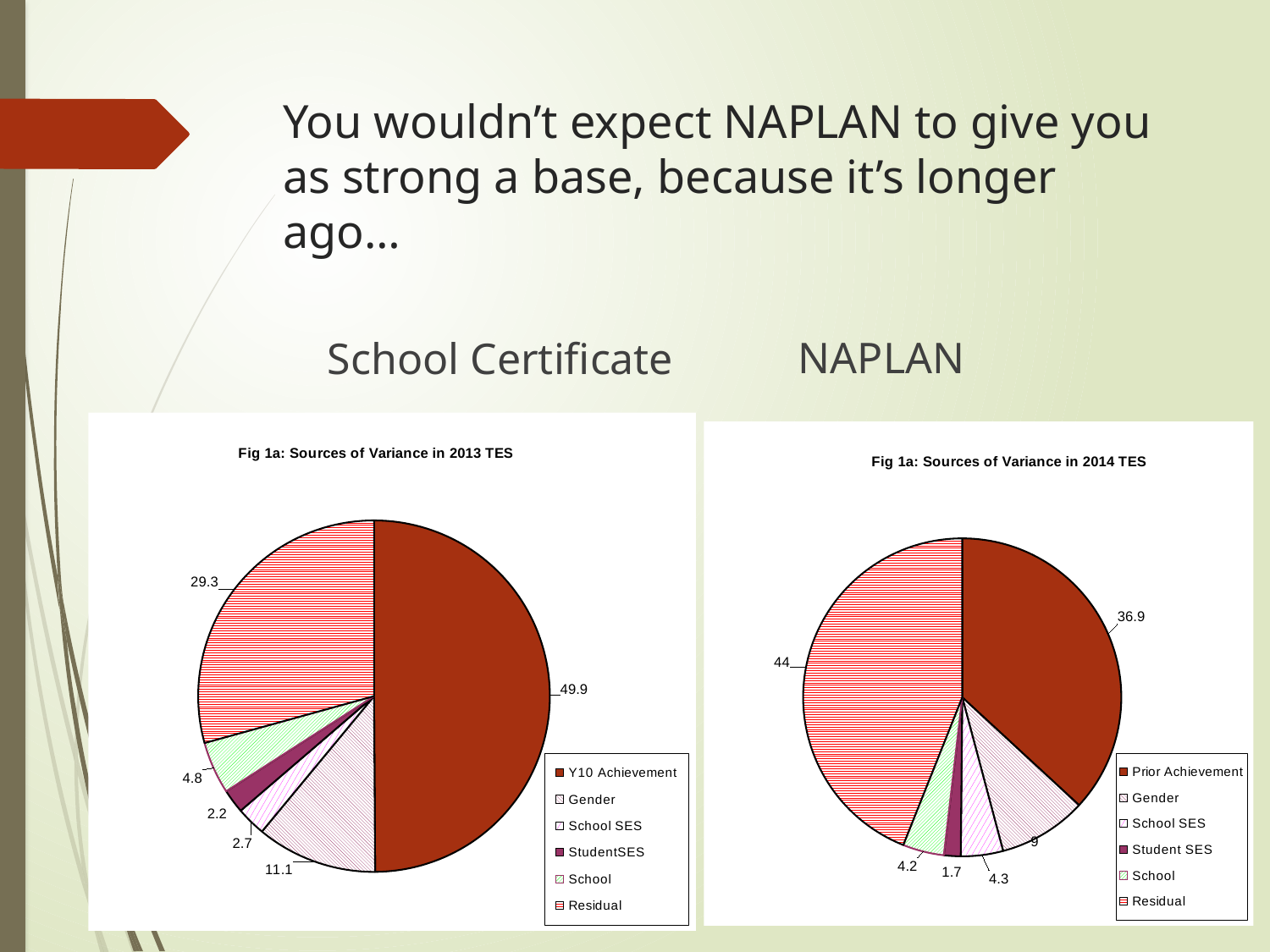
In the School Certificate chart (2013 TES), which source of variance has the smallest slice? StudentSES How many slices does the NAPLAN chart (2014 TES) have? 6 In the School Certificate chart (2013 TES), what is the difference between the Y10 Achievement value and the Residual value? 20.6 In the School Certificate chart (2013 TES), what value is shown for Residual? 29.3 In the School Certificate chart (Fig 1a: Sources of Variance in 2013 TES), what value is shown for Y10 Achievement? 49.9 In the NAPLAN chart (2014 TES), what is the difference between the Residual value and the Prior Achievement value? 7.1 In the School Certificate chart (2013 TES), which is larger: the Gender slice or the School slice? Gender In the NAPLAN chart (2014 TES), which source of variance has the largest slice? Residual In the NAPLAN chart (2014 TES), what value is shown for Residual? 44 In the NAPLAN chart (Fig 1a: Sources of Variance in 2014 TES), what value is shown for Prior Achievement? 36.9 In the NAPLAN chart (2014 TES), which source of variance has the smallest slice? Student SES What type of chart is used for the School Certificate figure (2013 TES)? Pie chart